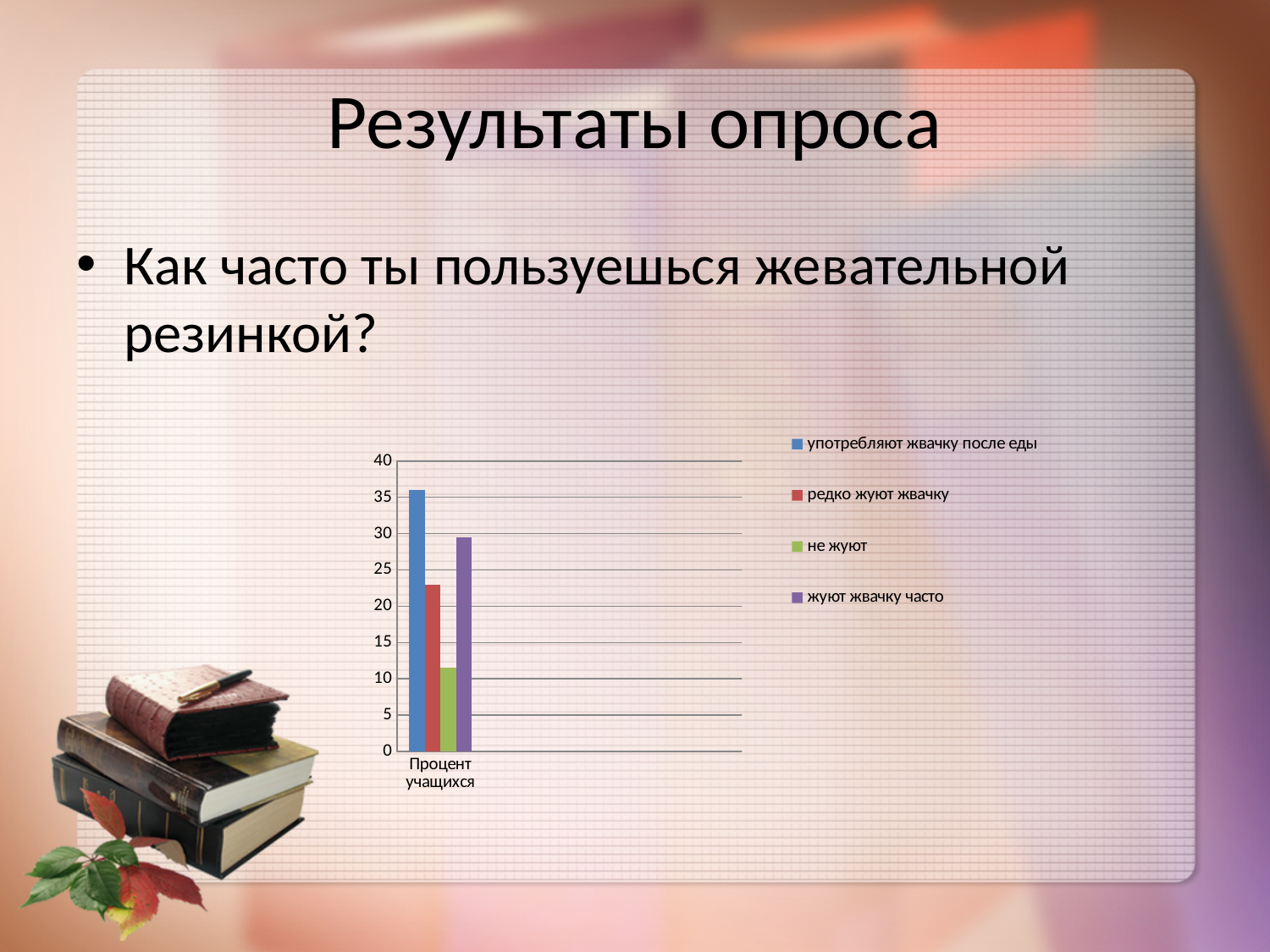
Which series has the highest bar? употребляют жвачку после еды Is the value for 'жуют жвачку часто' greater or less than 25? greater How many categories are shown on the x axis? 1 Is the value for 'редко жуют жвачку' greater or less than 25? less How many series does the legend list? 4 Which series has the lowest bar? не жуют Is the value for 'не жуют' greater or less than 15? less What kind of chart is shown on the slide? bar chart What is the label of the category on the x axis? Процент учащихся Which is larger: the bar for 'редко жуют жвачку' or the bar for 'жуют жвачку часто'? жуют жвачку часто Which is larger: the bar for 'не жуют' or the bar for 'редко жуют жвачку'? редко жуют жвачку